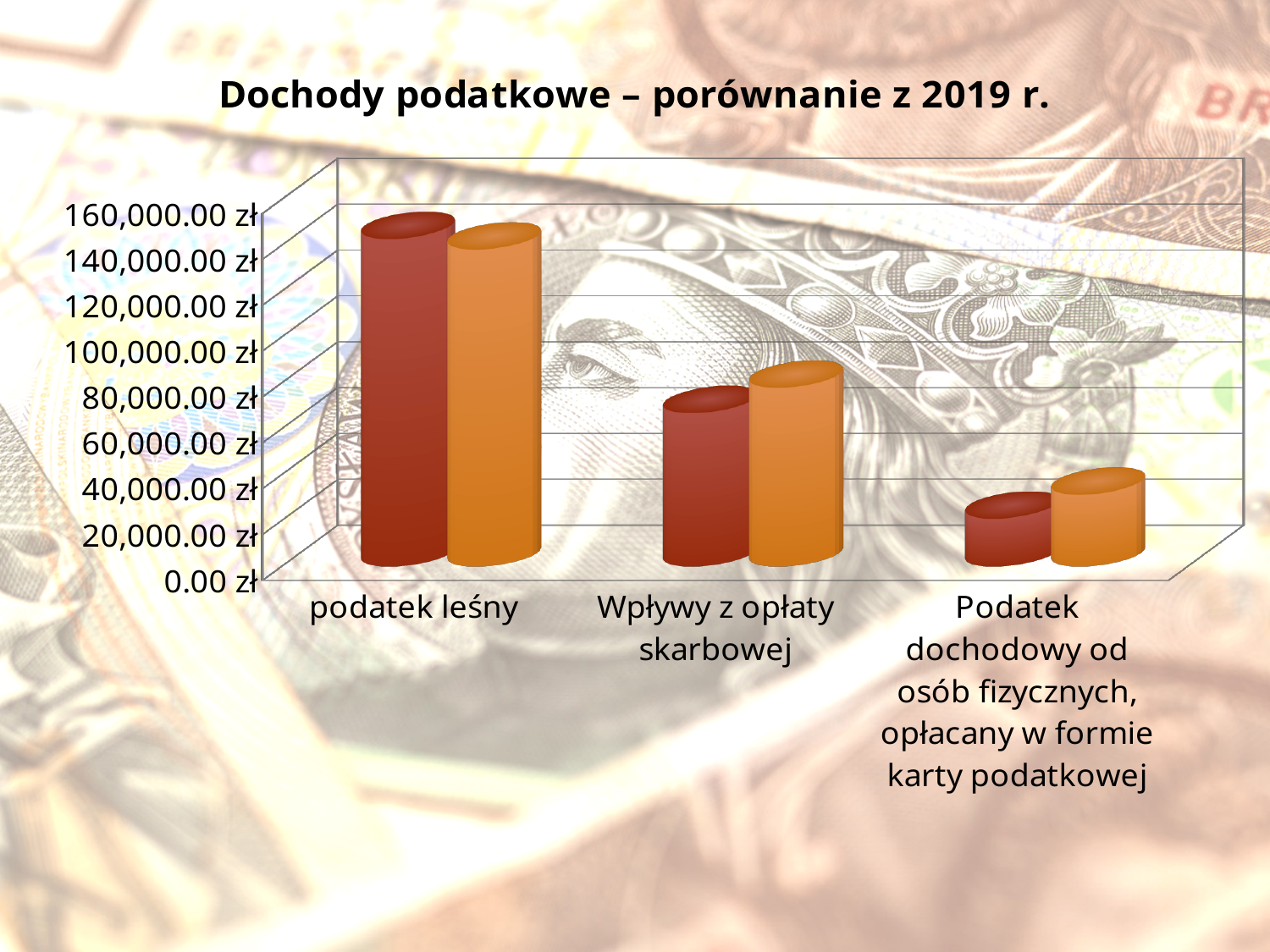
For Podatek dochodowy od osób fizycznych, opłacany w formie karty podatkowej, which bar is taller, the dark red one or the orange one? the orange one Is the value of the dark red bar for Podatek dochodowy od osób fizycznych, opłacany w formie karty podatkowej greater or less than 40,000.00 zł? less How many categories are shown on the x axis of the chart? 3 What kind of chart is shown on the slide? bar chart Is the value of the dark red bar for Wpływy z opłaty skarbowej greater or less than 100,000.00 zł? less Which category has the lowest values in the chart? Podatek dochodowy od osób fizycznych, opłacany w formie karty podatkowej Is the value of the dark red bar for podatek leśny greater or less than 120,000.00 zł? greater What is the title of the chart? Dochody podatkowe – porównanie z 2019 r. Do the values rise or fall moving from left to right along the x axis? fall Which category has the highest values in the chart? podatek leśny How many bars are plotted for each category in the chart? 2